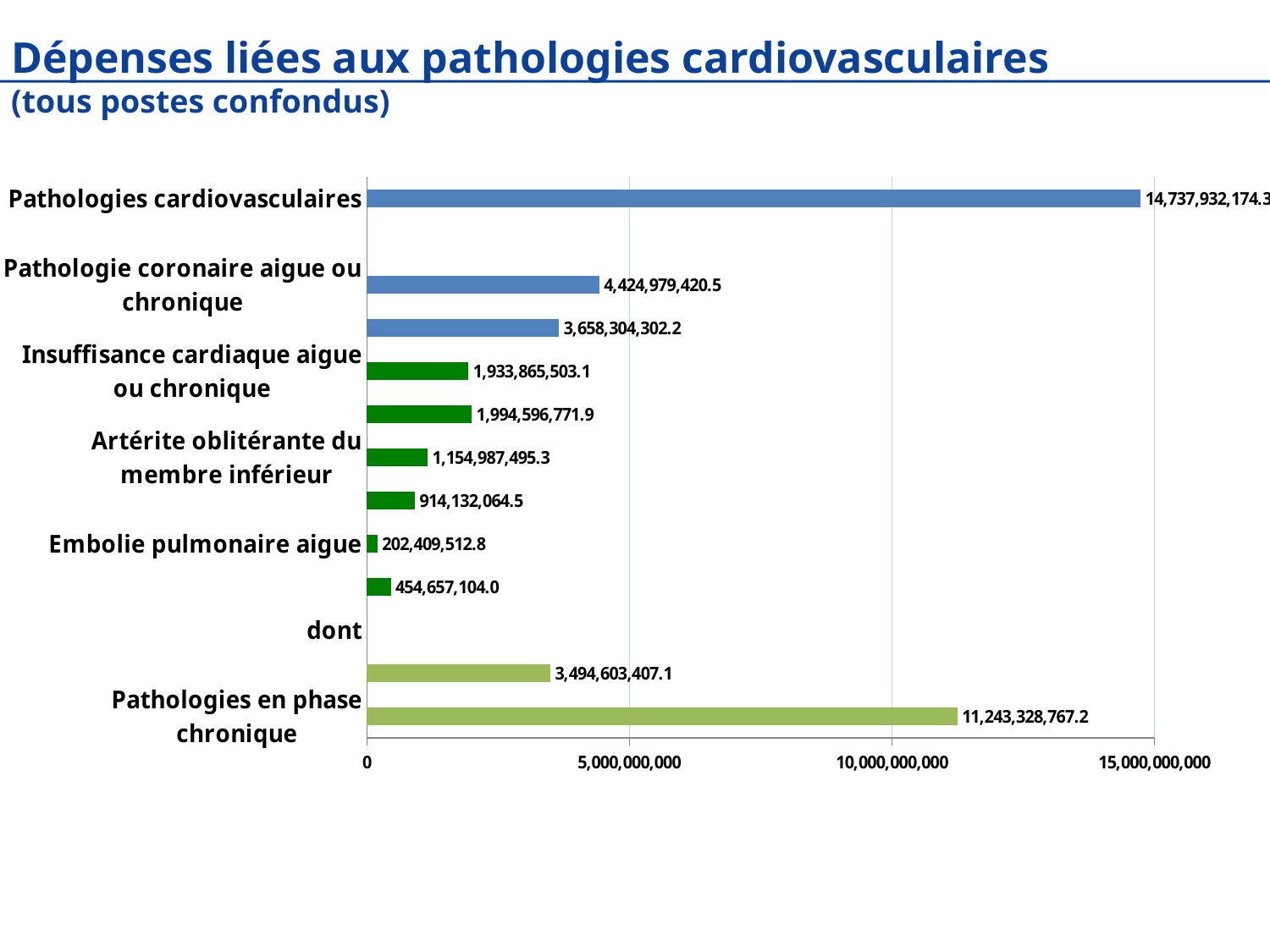
What is the title of the slide? Dépenses liées aux pathologies cardiovasculaires (tous postes confondus) What is the value of the shortest bar in the chart? 202,409,512.8 How many different bar colours are used in the chart? 3 What is the value of the bar for Pathologie coronaire aigue ou chronique? 4,424,979,420.5 Which is larger: the bar for Pathologies cardiovasculaires or the bar for Pathologies en phase chronique? Pathologies cardiovasculaires How many bars are plotted in the chart? 11 What type of chart is shown on the slide? bar chart Is the value for Pathologies en phase chronique greater or less than 10,000,000,000? greater What is the difference between the bar for Pathologies cardiovasculaires and the bar for Pathologie coronaire aigue ou chronique? 10,312,952,753.8 What is the value of the bar for Pathologies cardiovasculaires? 14,737,932,174.3 What is the value of the longest bar in the chart? 14,737,932,174.3 What is the value of the bar for Pathologies en phase chronique? 11,243,328,767.2